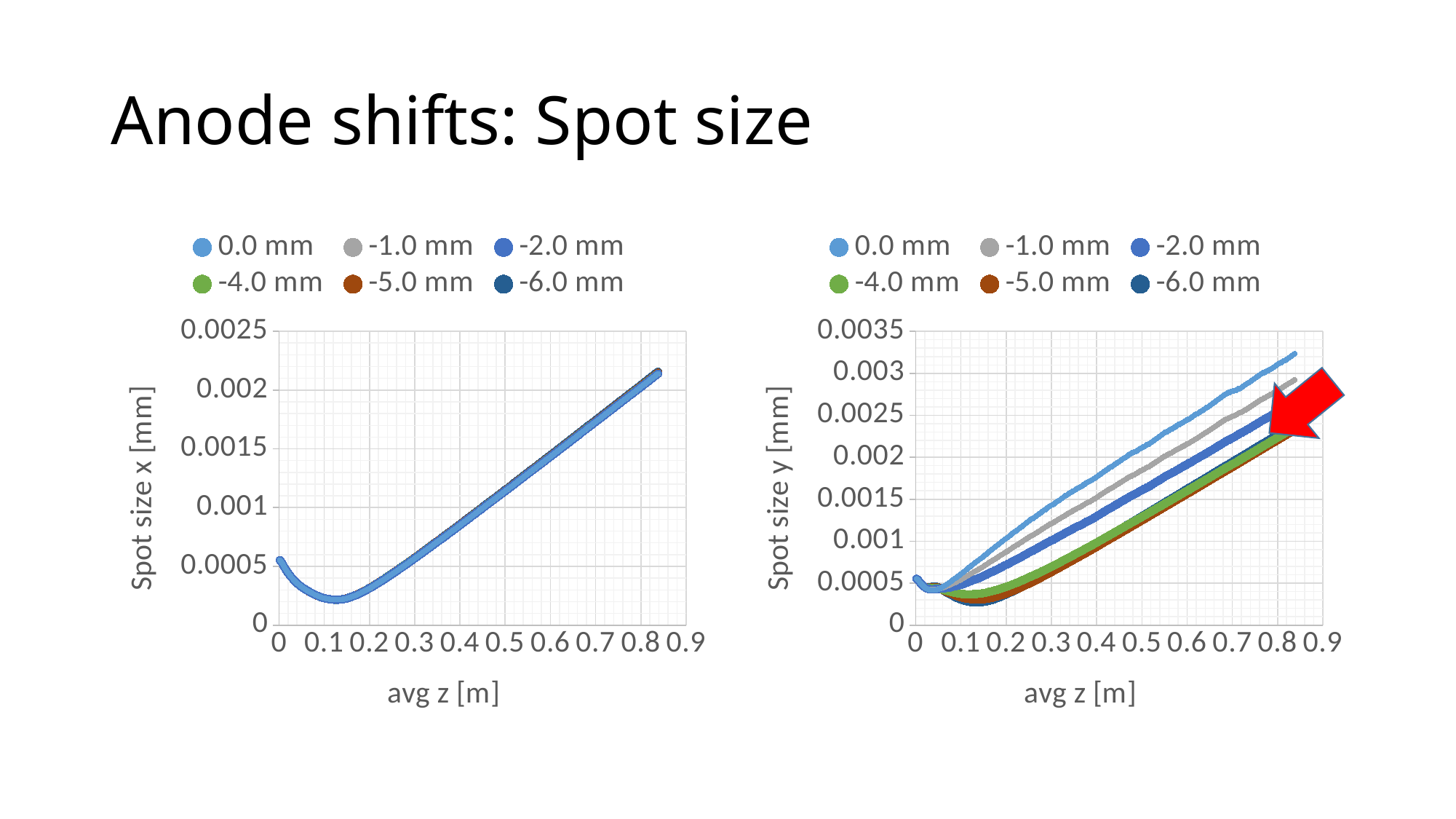
In the left chart (Spot size x), is the value at avg z = 0.8 m greater or less than 0.0015? greater In the left chart (Spot size x), is the minimum value of the curve near avg z = 0.1 m greater or less than 0.0005? less In the right chart (Spot size y), do the values rise or fall along the x axis between avg z = 0.2 m and 0.8 m? rise In the right chart (Spot size y), which is larger at avg z = 0.8 m: the 0.0 mm series or the -2.0 mm series? 0.0 mm What is the y-axis label of the left chart? Spot size x [mm] In the right chart (Spot size y), is the value of the 0.0 mm series at avg z = 0.8 m greater or less than 0.0025? greater In the left chart (Spot size x), do the values rise or fall along the x axis between avg z = 0.3 m and 0.8 m? rise What is the x-axis label of the right chart (Spot size y)? avg z [m] In the right chart (Spot size y), which series has the highest value at the right end of the x axis? 0.0 mm How many series does the legend of the left chart (Spot size x) list? 6 How many series does the legend of the right chart (Spot size y) list? 6 What type of chart is the left chart (Spot size x)? line chart